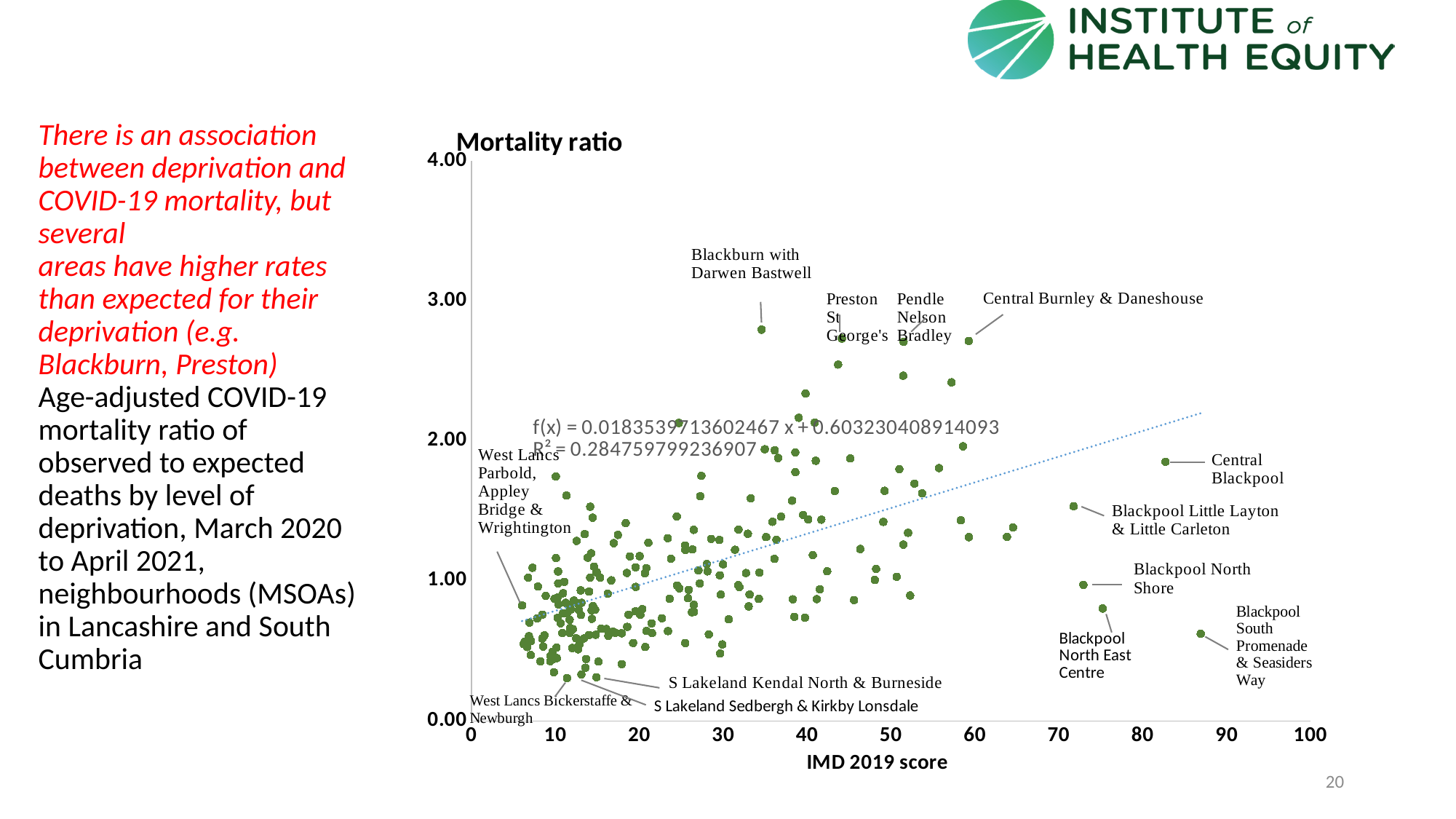
Is the mortality ratio for Blackpool South Promenade & Seasiders Way greater or less than 1.00? less Which has the higher mortality ratio, Blackburn with Darwen Bastwell or West Lancs Parbold, Appley Bridge & Wrightington? Blackburn with Darwen Bastwell Is the mortality ratio for Central Blackpool greater or less than 1.00? greater Is the mortality ratio for West Lancs Bickerstaffe & Newburgh greater or less than 1.00? less Does the dotted trendline rise or fall as the IMD 2019 score increases? Rises Which of the labelled Blackpool neighbourhoods has the highest mortality ratio? Central Blackpool What R² value is printed on the chart for the trendline? 0.284759799236907 What kind of chart is shown on the slide? Scatter plot Which has the higher mortality ratio, Central Blackpool or Blackpool North Shore? Central Blackpool What is the label on the x axis of the chart? IMD 2019 score